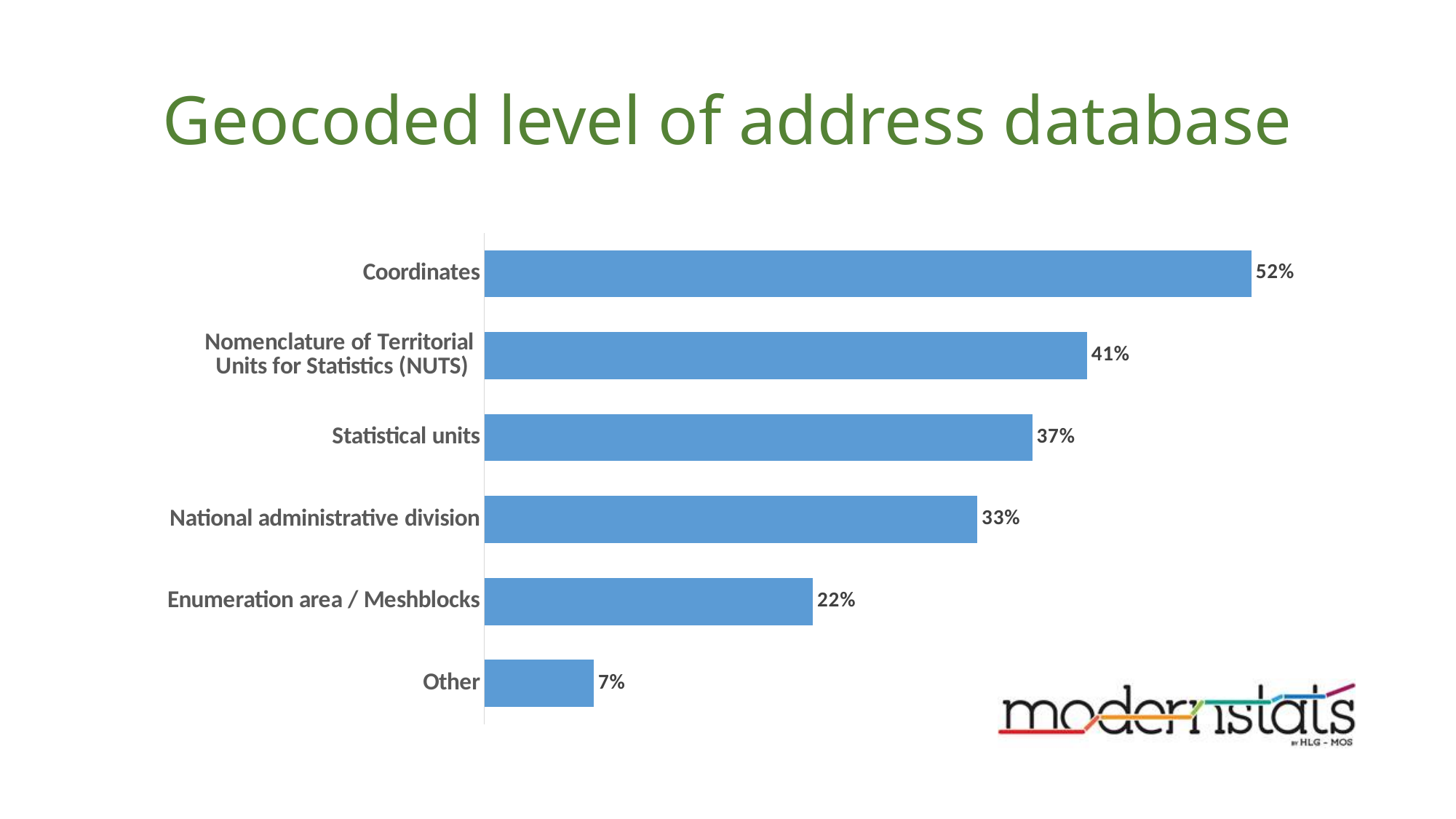
What is the value for Enumeration area / Meshblocks? 22% Which category has the highest value? Coordinates Which category has the lowest value? Other What is the difference between the values for National administrative division and Enumeration area / Meshblocks? 11% What is the value for Other? 7% What kind of chart is shown on the slide? Bar chart Which is larger, the value for Statistical units or the value for National administrative division? Statistical units What is the value for Coordinates? 52% What is the difference between the values for Coordinates and Statistical units? 15% How many categories are shown in the chart? 6 What is the value for Nomenclature of Territorial Units for Statistics (NUTS)? 41% What is the title of the slide? Geocoded level of address database